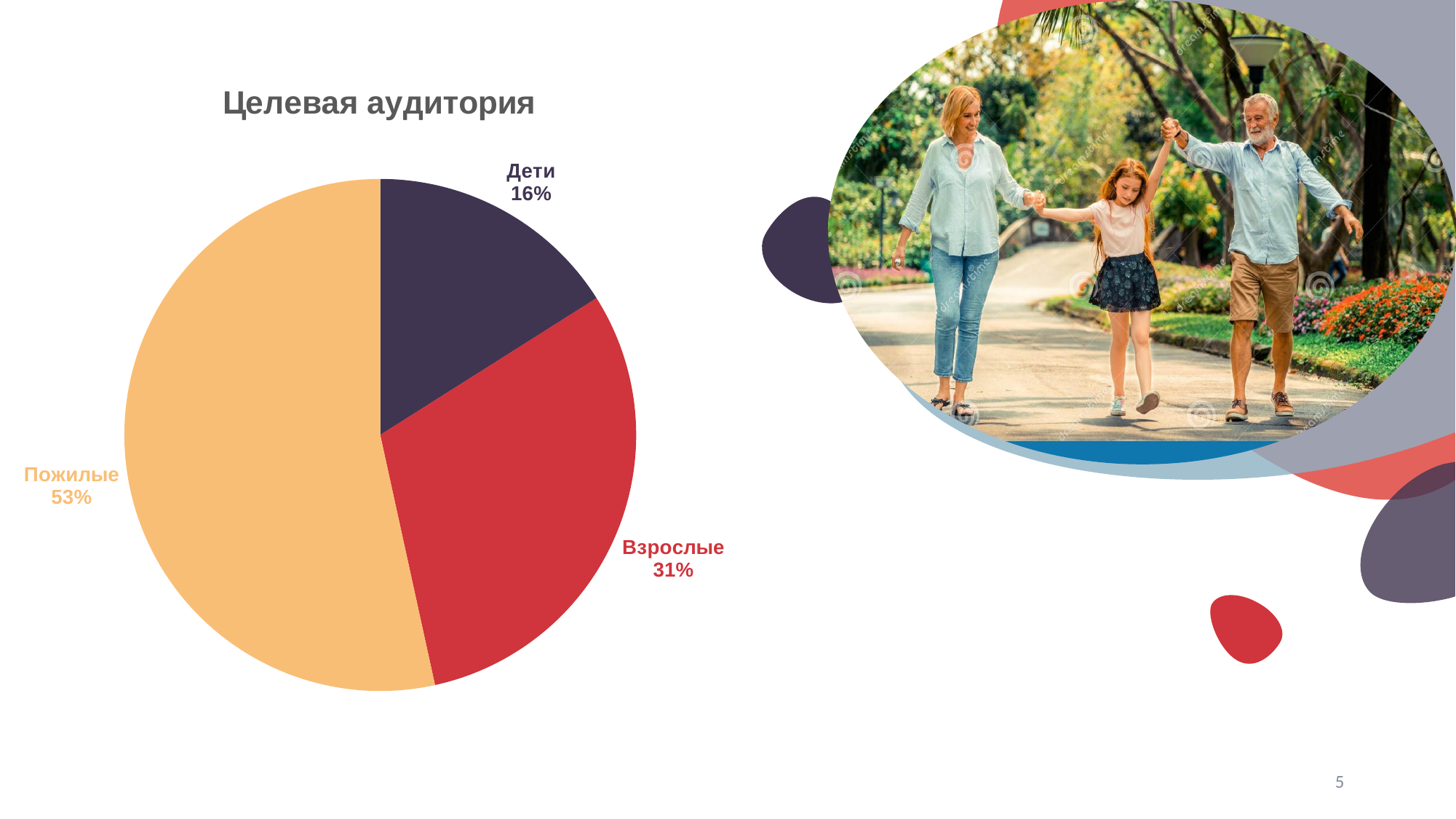
What share of the pie does Взрослые have? 31% How many categories are shown in the pie chart? 3 What is the title of the chart? Целевая аудитория What share of the pie does Дети have? 16% Which is larger, the share for Взрослые or the share for Дети? Взрослые What is the difference in percentage points between Пожилые and Взрослые? 22 What colour is the slice for Взрослые? Red Which category has the smallest slice of the pie? Дети What is the difference in percentage points between Взрослые and Дети? 15 What kind of chart is shown on the slide? Pie chart What share of the pie does Пожилые have? 53% Which category has the largest slice of the pie? Пожилые